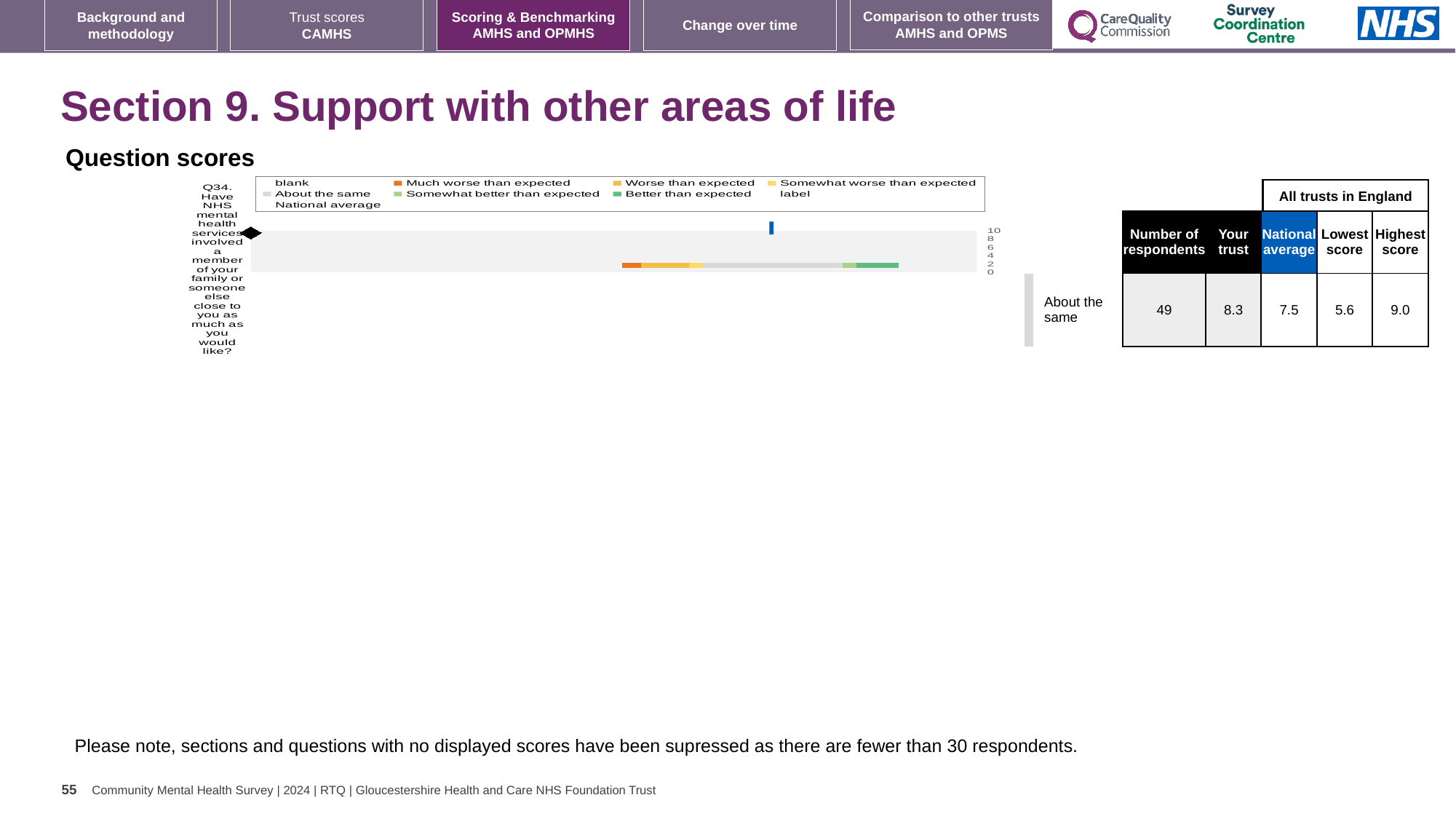
How many questions (categories) are plotted in the Question scores chart? 1 What is the highest value shown on the score axis of the Question scores chart? 10 In the Question scores chart, which legend entry is shown in dark green? Better than expected What benchmark category is given for Q34 next to the Question scores chart? About the same Which question number is plotted in the Question scores chart? Q34 What kind of chart is shown under 'Question scores'? bar chart